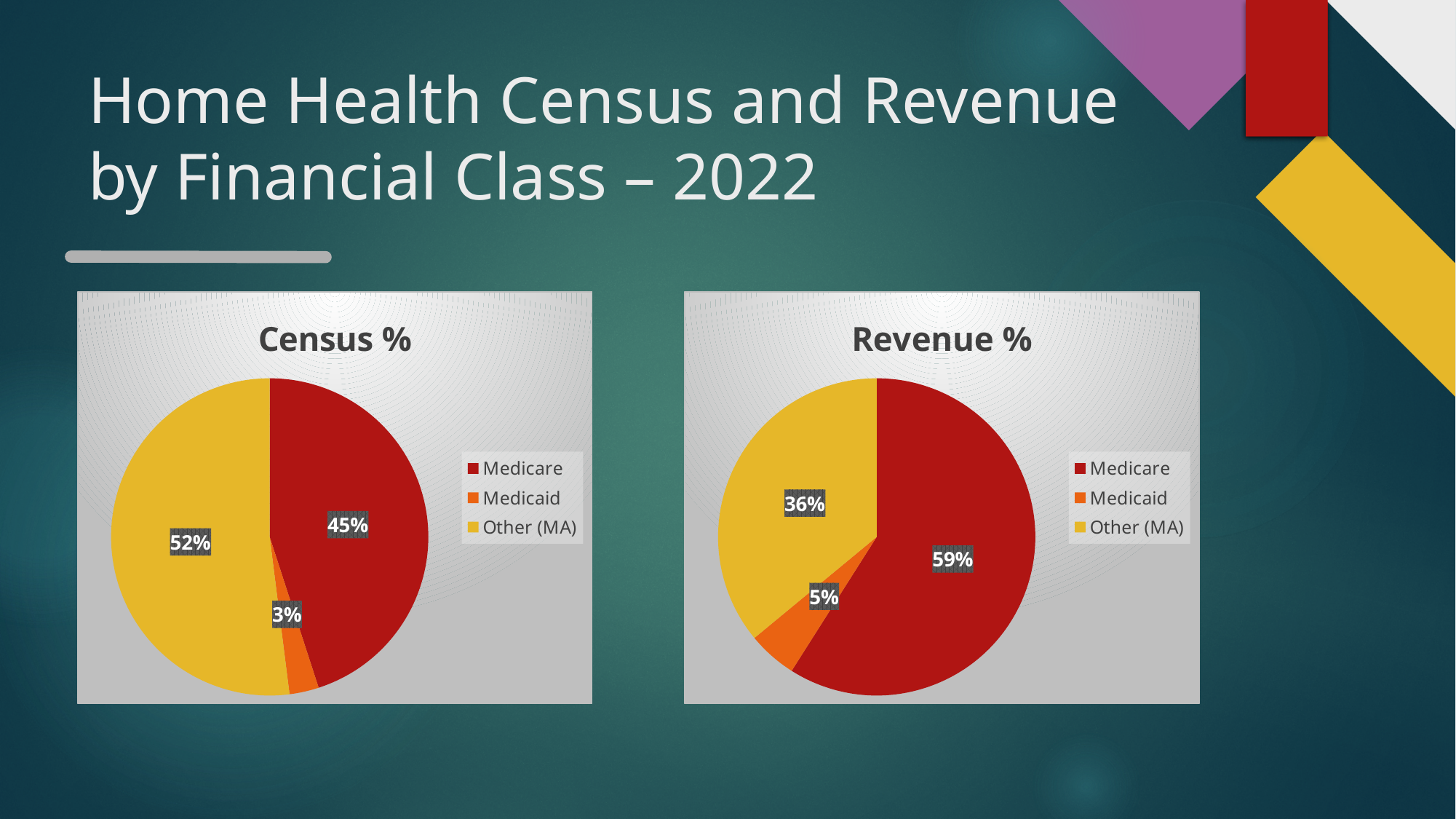
In the Census % chart, what share does Medicare have? 45% In the Census % chart, what colour represents Medicaid? Orange In the Census % chart, which is larger, the Medicare slice or the Other (MA) slice? Other (MA) In the Revenue % chart, what is the difference between the Medicare and Other (MA) shares? 23% In the Census % chart, which category has the largest slice? Other (MA) What is the title of the chart on the right side of the slide? Revenue % In the Revenue % chart, which category has the smallest slice? Medicaid What kind of chart is the Census % chart? Pie chart How many categories does the Revenue % chart show? 3 In the Revenue % chart, what share does Medicaid have? 5% In the Revenue % chart, what share does Medicare have? 59% In the Census % chart, what share does Other (MA) have? 52%